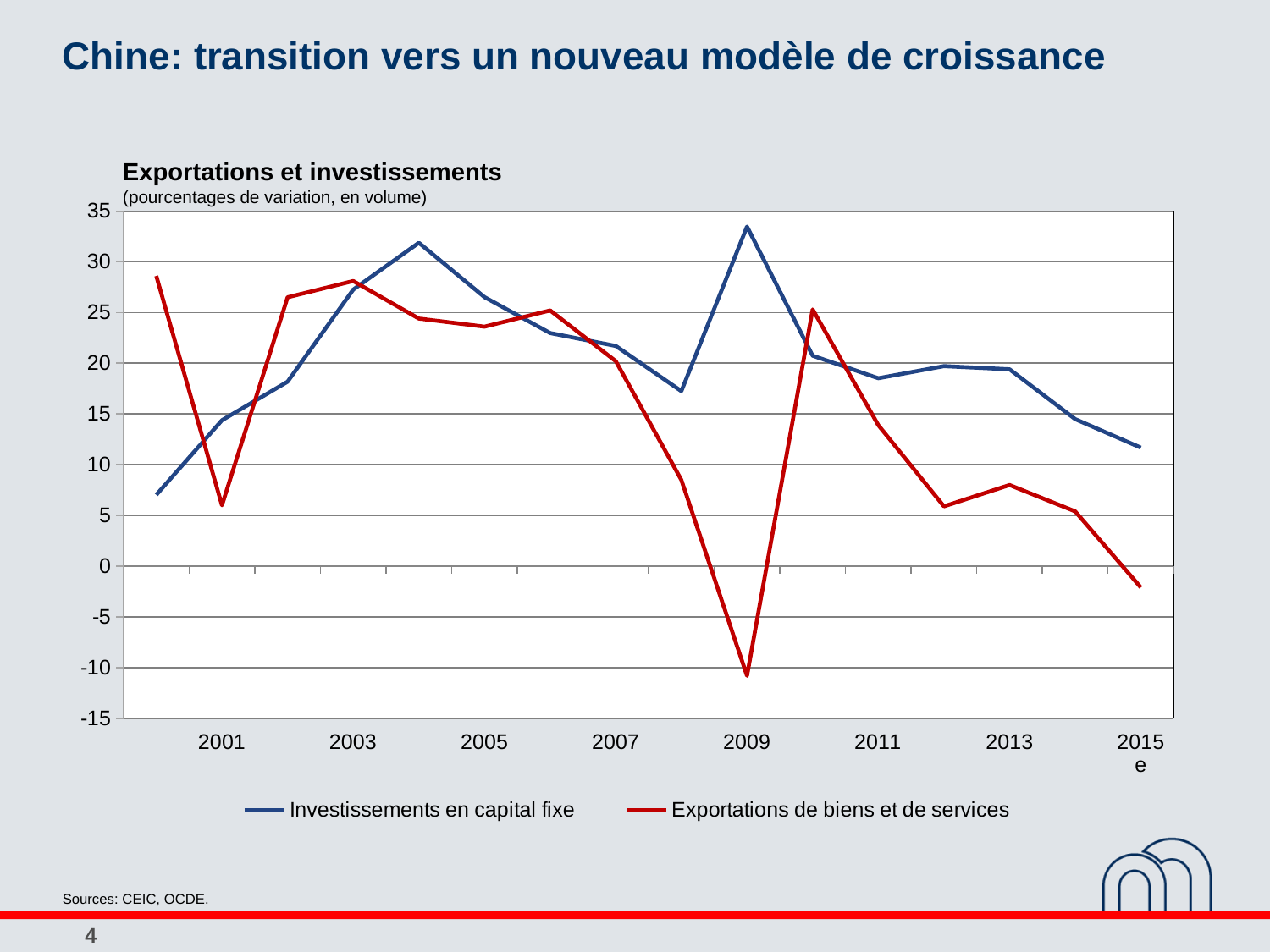
What kind of chart is shown on the slide? line chart In 2001, which series has the higher value: Investissements en capital fixe or Exportations de biens et de services? Investissements en capital fixe Does the Exportations de biens et de services series rise or fall overall from 2010 to 2015e? fall In which year does the Investissements en capital fixe series reach its highest value? 2009 What are the two series named in the legend? Investissements en capital fixe; Exportations de biens et de services In which year does the Exportations de biens et de services series reach its lowest value? 2009 In which year does the Investissements en capital fixe series have its lowest value? 2000 How many series does the legend list? 2 What is the title of the chart? Exportations et investissements Is the value for Investissements en capital fixe in 2015e greater or less than 15? less Is the value for Exportations de biens et de services in 2000 greater or less than 25? greater Is the value for Exportations de biens et de services in 2009 greater or less than -5? less